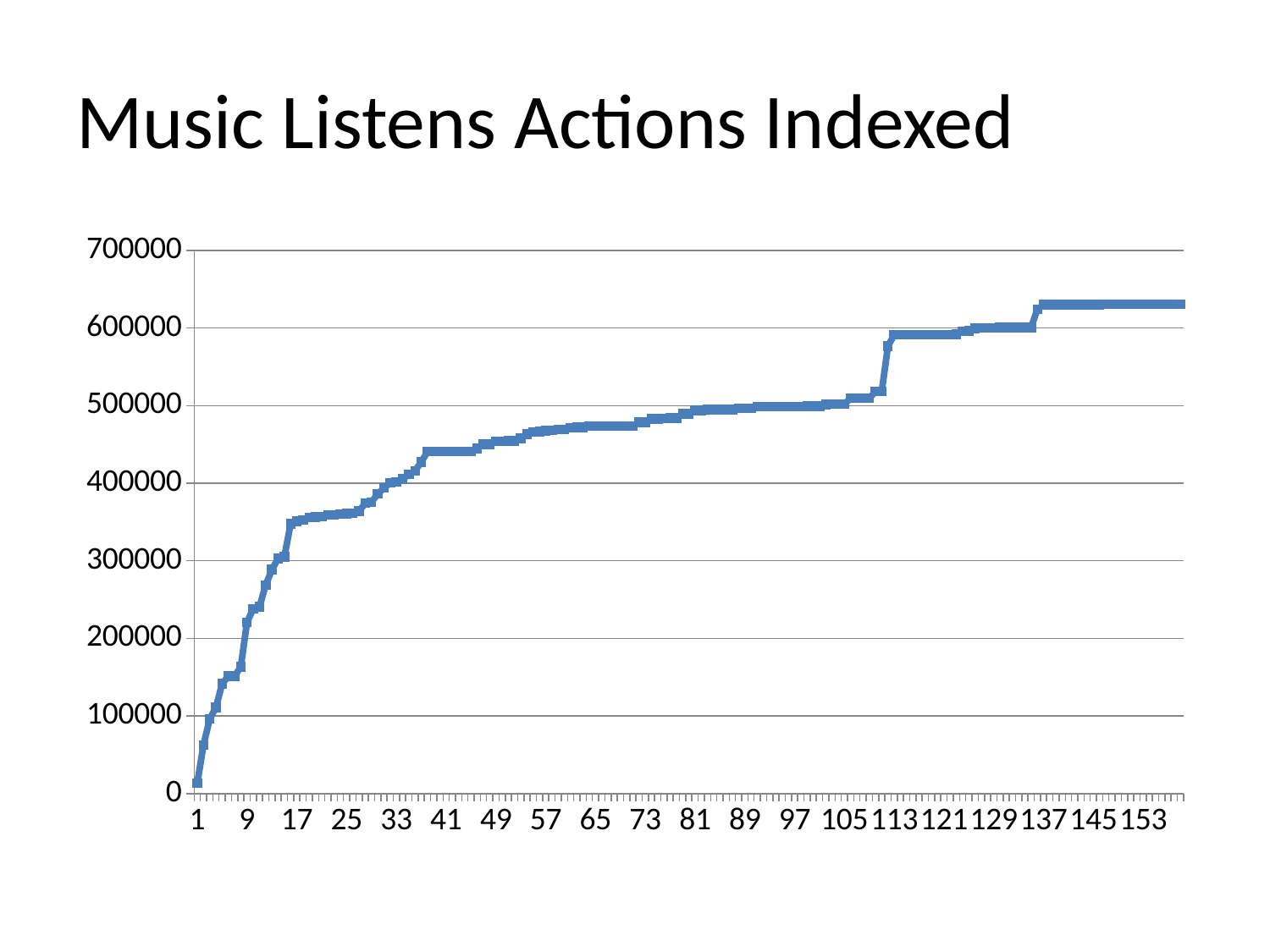
Is the value at x = 65 greater or less than 500000? less Is the value at x = 17 greater or less than 300000? greater Do the values generally rise or fall as the x axis increases? rise Is the value at x = 1 greater or less than 100000? less What is the highest value shown on the y axis? 700000 What is the title of the chart? Music Listens Actions Indexed At which x-axis value is the line at its lowest point? 1 What kind of chart is shown on the slide? line chart